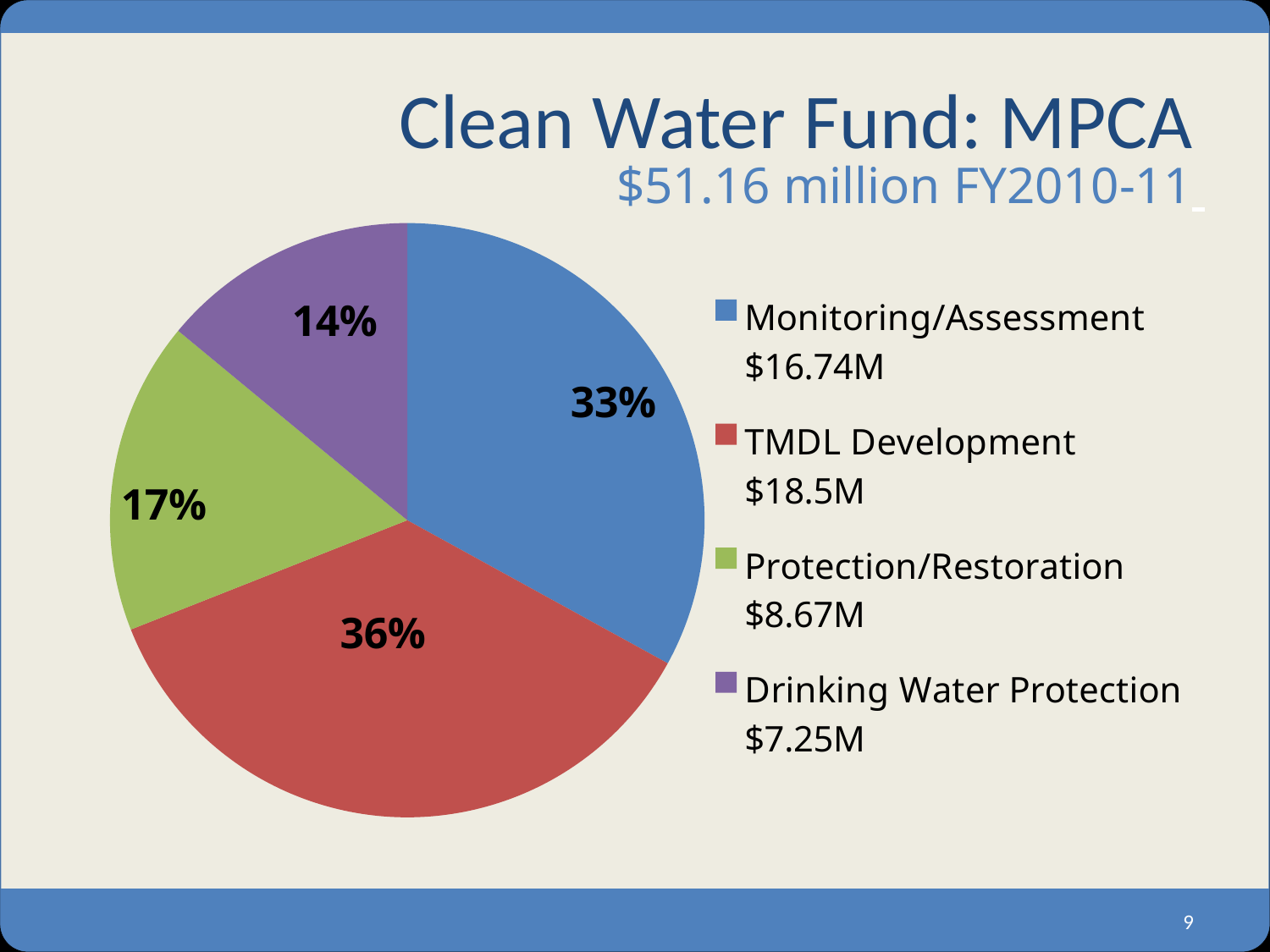
What dollar amount is listed for Drinking Water Protection in the legend? $7.25M What percentage share does TMDL Development have in the pie chart? 36% What type of chart is shown on the slide? pie chart What dollar amount is listed for Monitoring/Assessment in the legend? $16.74M What percentage share does Monitoring/Assessment have in the pie chart? 33% What is the difference in percentage points between the TMDL Development and Protection/Restoration slices? 19 What percentage share does Protection/Restoration have in the pie chart? 17% Which category has the smallest share of the pie? Drinking Water Protection How many categories are shown in the pie chart? 4 Which category has the largest share of the pie? TMDL Development Which slice is larger, Monitoring/Assessment or Protection/Restoration? Monitoring/Assessment